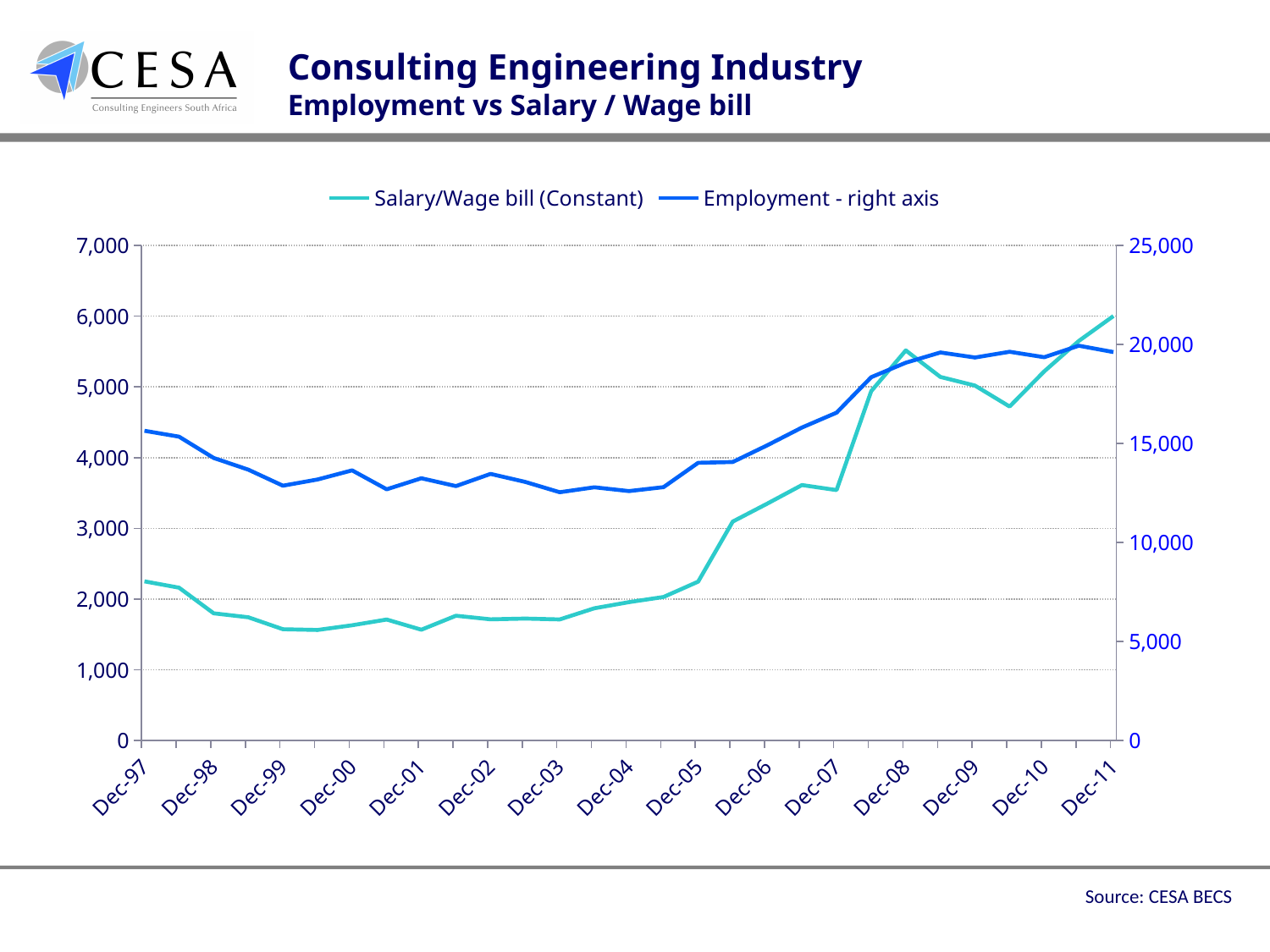
Does the Salary/Wage bill (Constant) line rise or fall between Dec-05 and Dec-08? rise What kind of chart is shown on the slide? line chart How many series does the legend list? 2 Does the Employment line rise or fall between Dec-97 and Dec-99? fall Is the Employment value at Dec-11 greater or less than 15,000 on the right axis? greater Is the Employment value at Dec-99 greater or less than 15,000 on the right axis? less What are the two series named in the legend? Salary/Wage bill (Constant) and Employment - right axis Is the Salary/Wage bill (Constant) value at Dec-99 greater or less than 2,000? less How many dates are labelled on the x axis? 15 At which labelled date is the Salary/Wage bill (Constant) highest? Dec-11